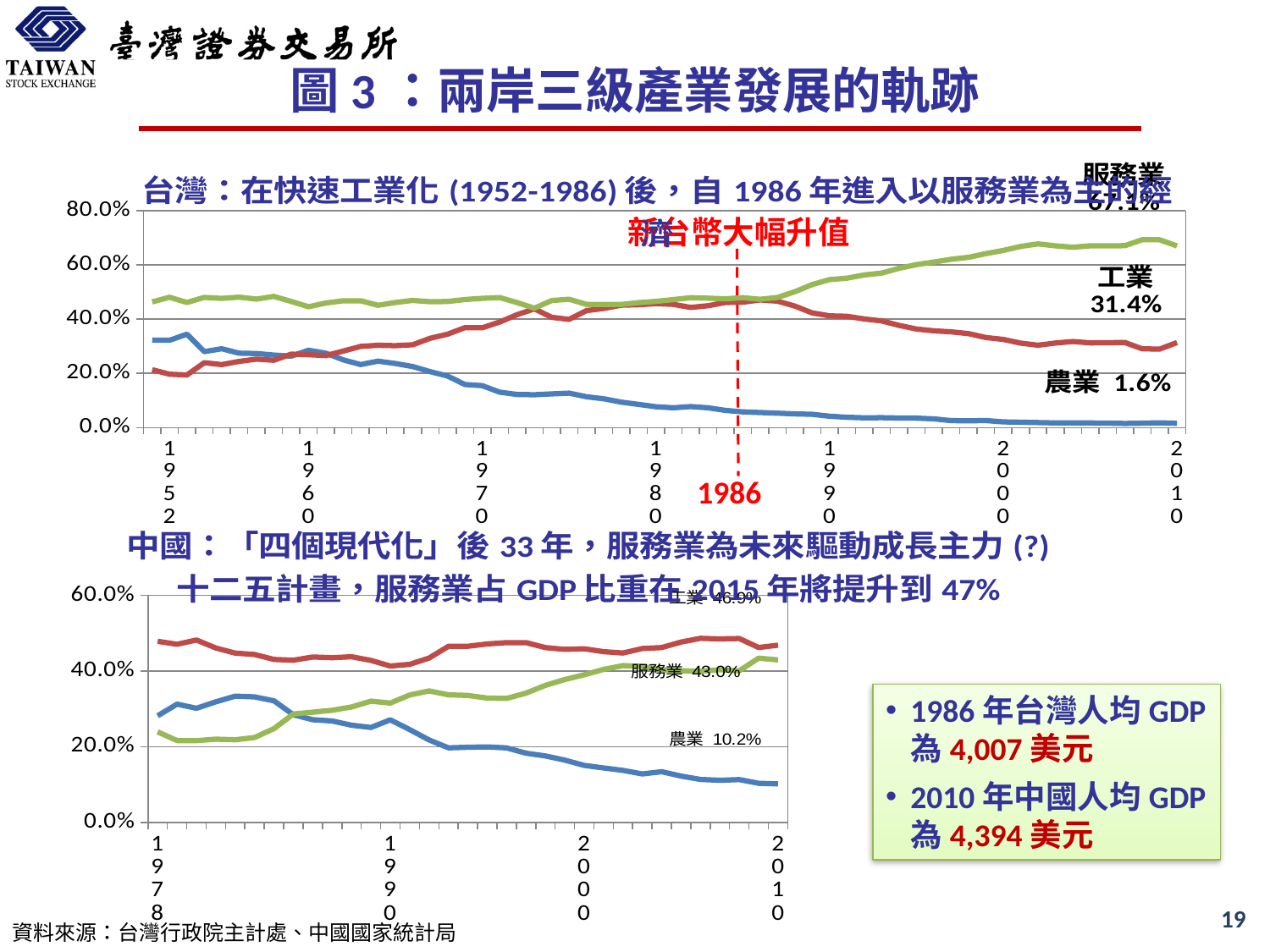
In the bottom chart (China), what is the final value shown for 農業? 10.2% In the top chart (Taiwan), does the 農業 line rise or fall from 1952 to 2010? fall In the bottom chart (China), is the value of the 工業 line in 1978 greater or less than 40.0%? greater In the bottom chart (China), what is the final value shown for 服務業? 43.0% In the top chart (Taiwan), what is the final value shown for 工業? 31.4% In the top chart (Taiwan), what is the final value shown for 服務業? 67.1% In the top chart (Taiwan), what is the final value shown for 農業? 1.6% What kind of chart is the bottom chart (China)? line chart In the bottom chart (China), what is the difference between the labelled final values of 工業 and 服務業? 3.9% In the top chart (Taiwan), is the value of the 農業 line in 1952 greater or less than 20.0%? greater In the bottom chart (China), which sector has the highest labelled final value? 工業 In the top chart (Taiwan), what is the difference between the labelled final values of 服務業 and 工業? 35.7%